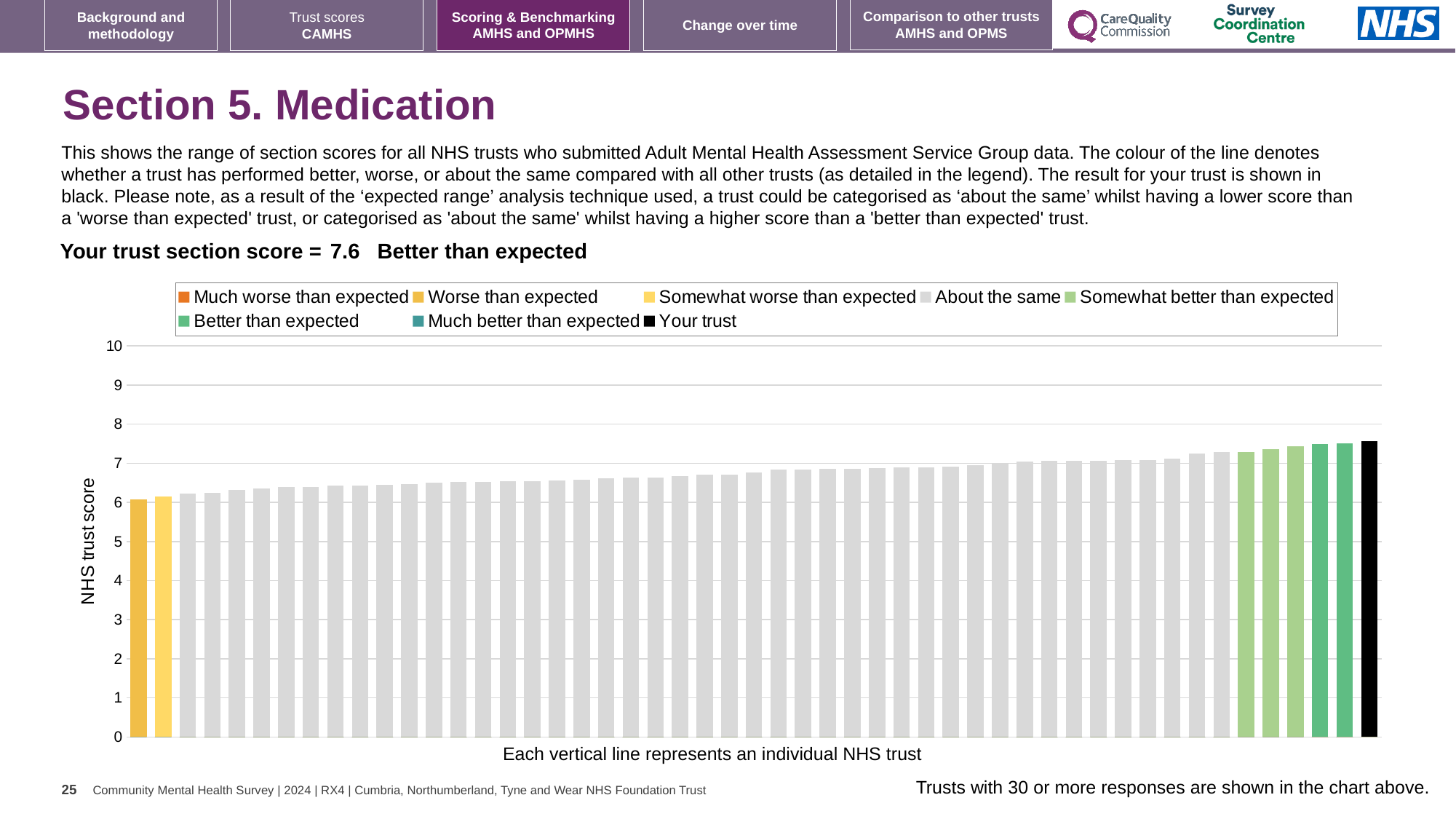
Is the value of the leftmost (lowest) bar greater or less than 7? less Which performance category is your trust placed in for this section? Better than expected Do the bar values rise or fall from left to right across the chart? rise How many bars are coloured as 'Somewhat better than expected' (light green)? 3 Is the value of the black 'Your trust' bar greater or less than 8? less Is the value of the leftmost (lowest) bar greater or less than 5? greater What kind of chart is shown on the slide? bar chart What is the section score for your trust shown on the slide? 7.6 What colour is used for the 'Your trust' bar in the chart? black What is the label on the vertical axis of the chart? NHS trust score How many entries does the chart legend list? 8